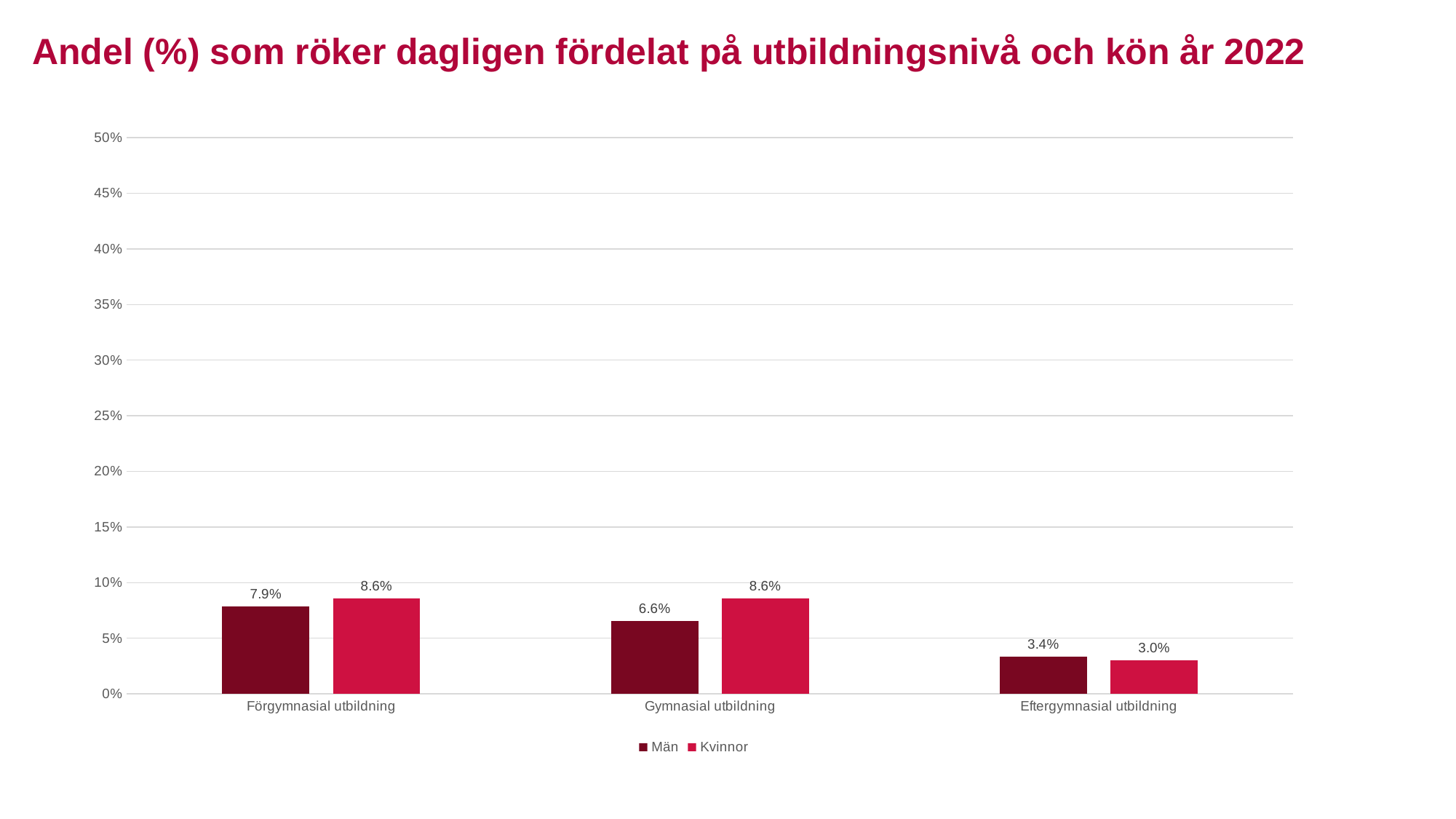
What is the value for Kvinnor in the Eftergymnasial utbildning category? 3.0% What is the title of the chart? Andel (%) som röker dagligen fördelat på utbildningsnivå och kön år 2022 What is the value for Män in the Gymnasial utbildning category? 6.6% Which education category has the lowest value for Män? Eftergymnasial utbildning What kind of chart is shown on the slide? Bar chart What is the difference between the Kvinnor and Män values in the Gymnasial utbildning category? 2.0% How many series does the legend list? 2 Is the value for Kvinnor in the Förgymnasial utbildning category greater or less than 10%? less How many education categories are shown on the x axis? 3 What is the value for Män in the Förgymnasial utbildning category? 7.9% In the Eftergymnasial utbildning category, which is larger, the value for Män or for Kvinnor? Män What is the value for Kvinnor in the Gymnasial utbildning category? 8.6%